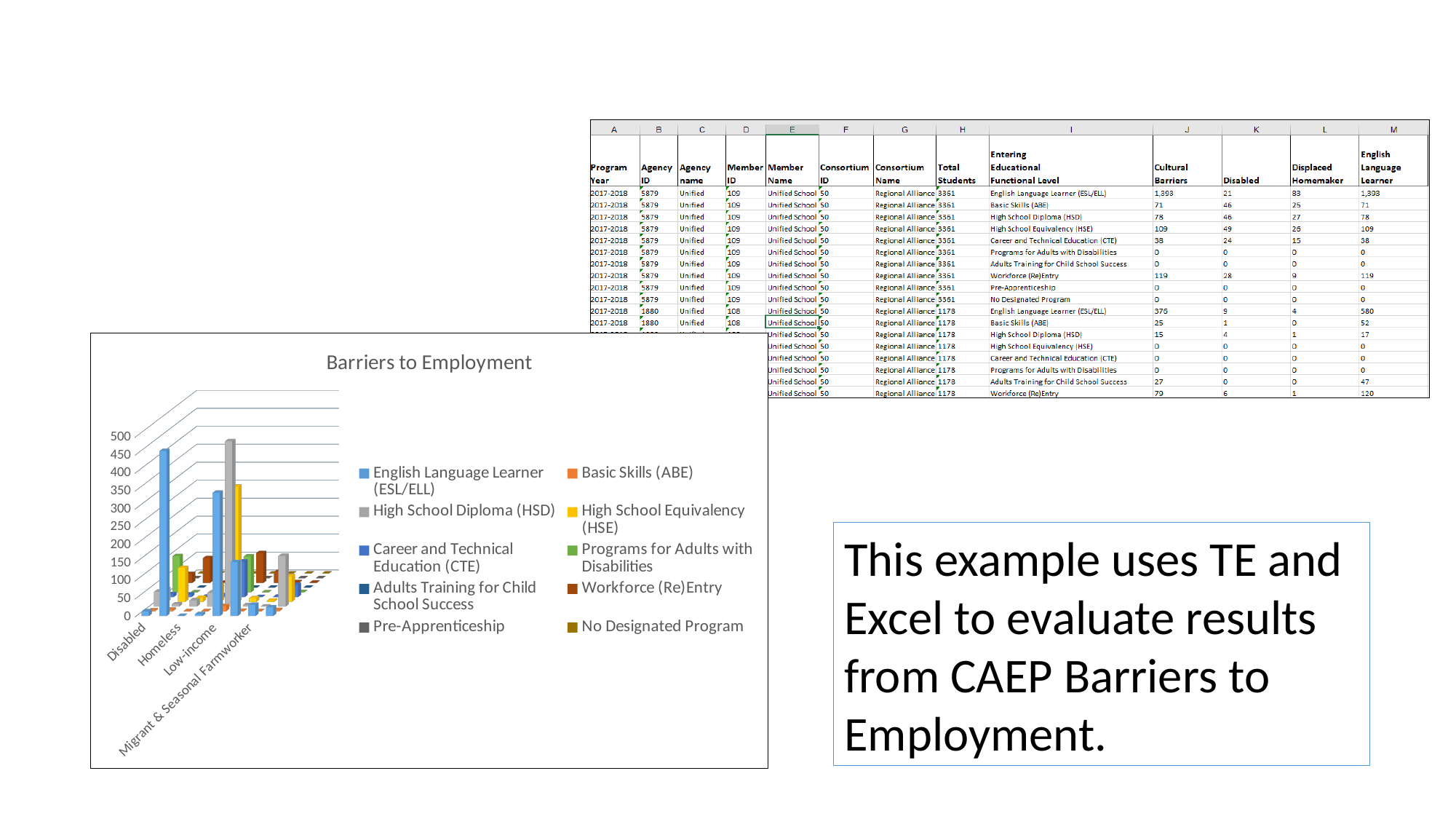
What is the title of the chart on the slide? Barriers to Employment In the "Barriers to Employment" chart, is the value for English Language Learner (ESL/ELL) in the Migrant & Seasonal Farmworker category greater or less than 100? less How many series does the legend of the "Barriers to Employment" chart list? 10 What kind of chart is the "Barriers to Employment" chart? bar chart In the "Barriers to Employment" chart, which category is listed first on the x axis? Disabled In the "Barriers to Employment" chart, what is the highest value shown on the vertical axis? 500